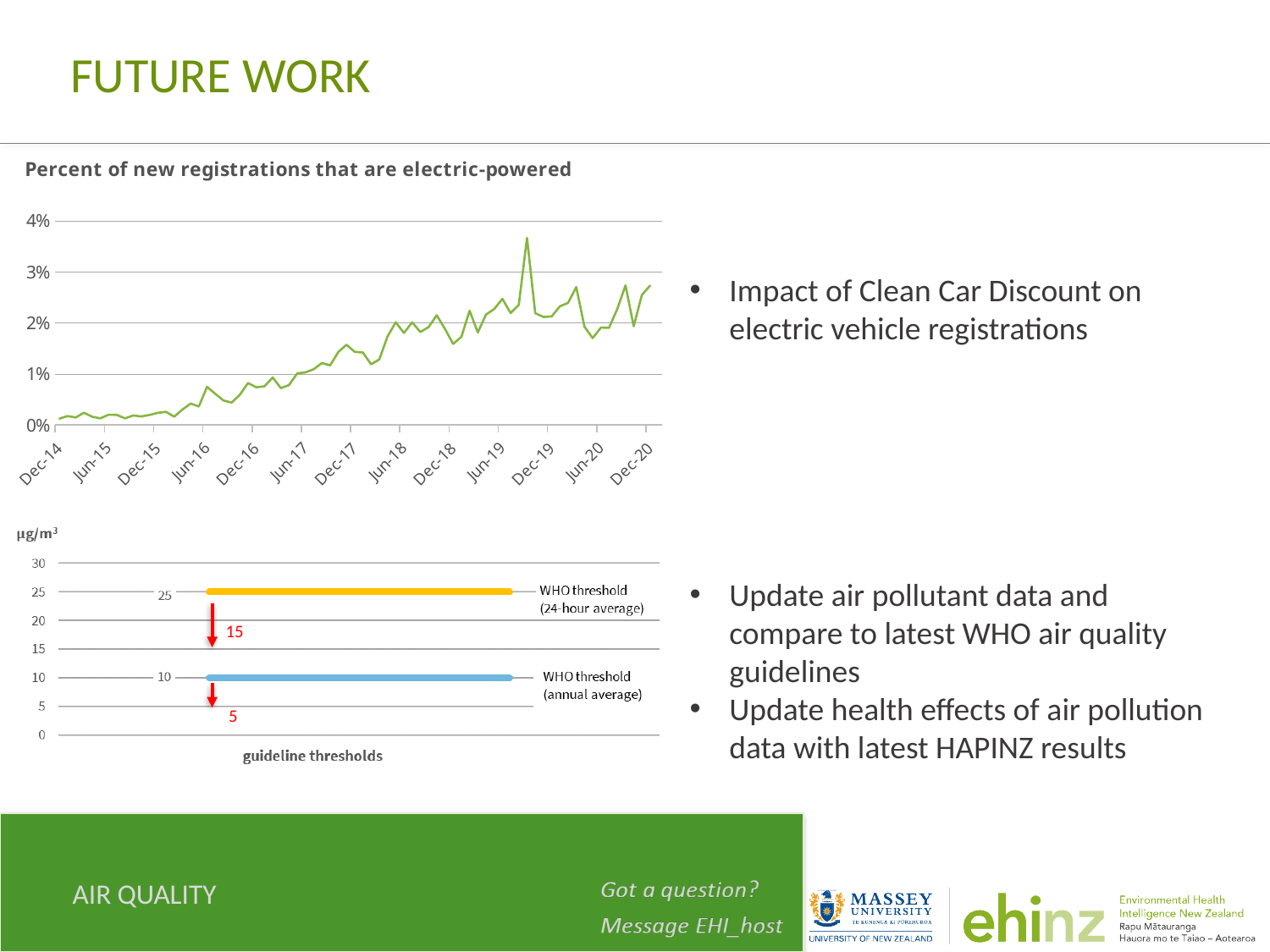
In the bottom chart, which is larger, the WHO threshold (24-hour average) or the WHO threshold (annual average)? WHO threshold (24-hour average) In the bottom chart, what is the difference between the WHO threshold (24-hour average) and the WHO threshold (annual average)? 15 In the top chart, how many date labels are shown along the horizontal axis? 13 In the top chart, 'Percent of new registrations that are electric-powered', do the values generally rise or fall from Dec-14 to Dec-20? rise In the top chart, is the value at Dec-14 greater or less than 1%? less In the top chart, what is the highest value shown on the vertical axis? 4% In the top chart, is the value at Dec-20 greater or less than 2%? greater In the bottom chart, what is the value of the WHO threshold (24-hour average)? 25 In the bottom chart, what is the value of the WHO threshold (annual average)? 10 What is the title of the top chart? Percent of new registrations that are electric-powered In the top chart, is the highest peak of the line greater or less than 3%? greater What type of chart is the top chart, 'Percent of new registrations that are electric-powered'? line chart